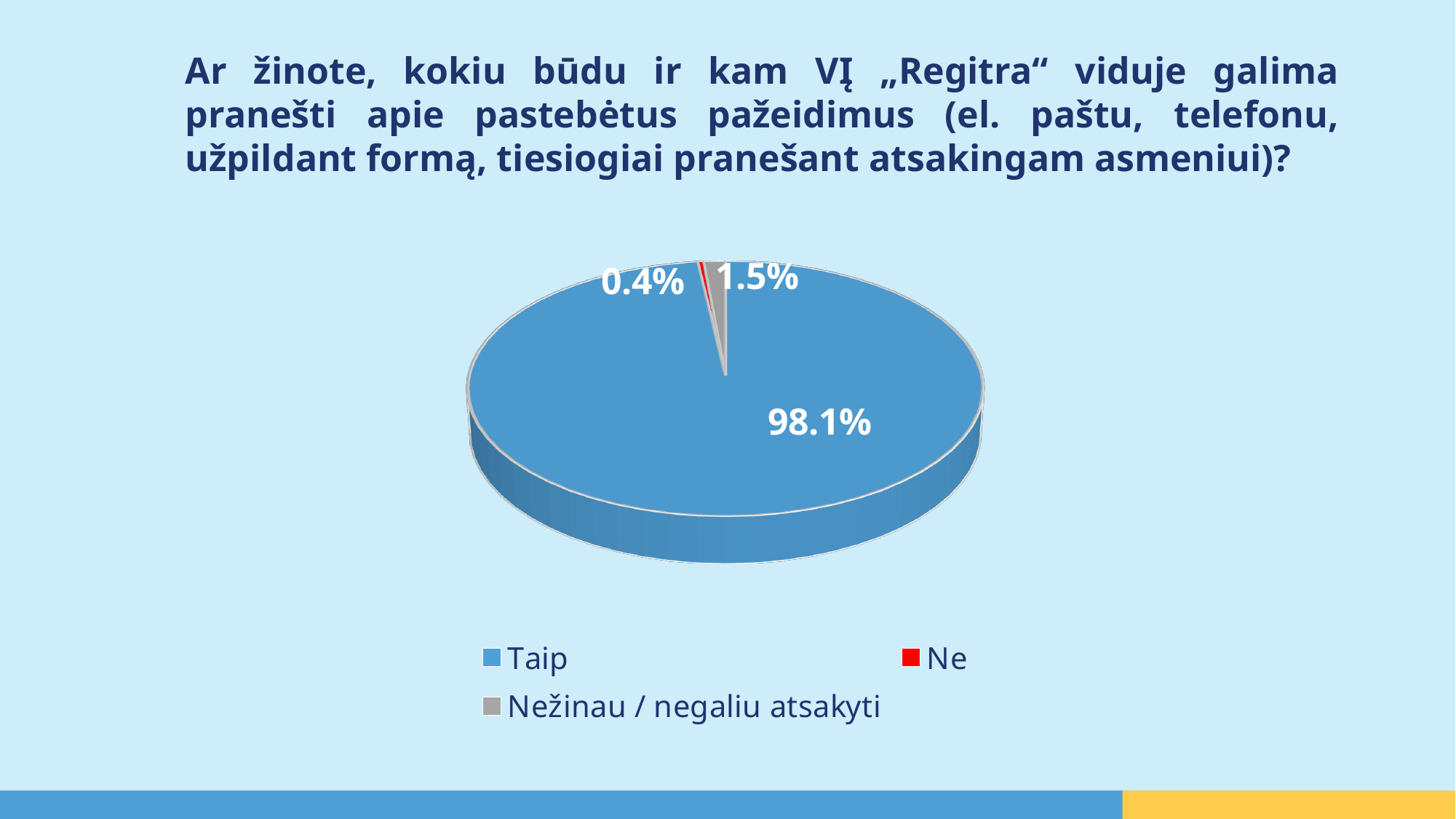
What kind of chart is shown on the slide? pie chart What percentage of respondents answered "Taip"? 98.1% What is the difference in percentage points between the "Taip" share and the "Nežinau / negaliu atsakyti" share? 96.6 What colour is the slice for "Taip"? blue How many categories does the pie chart have? 3 What percentage of respondents answered "Ne"? 0.4% What percentage of respondents answered "Nežinau / negaliu atsakyti"? 1.5% Which is larger, the share for "Ne" or the share for "Nežinau / negaliu atsakyti"? Nežinau / negaliu atsakyti What colour is the slice for "Ne"? red What is the difference in percentage points between the "Nežinau / negaliu atsakyti" share and the "Ne" share? 1.1 Which answer category has the smallest share of the pie? Ne Which answer category has the largest share of the pie? Taip